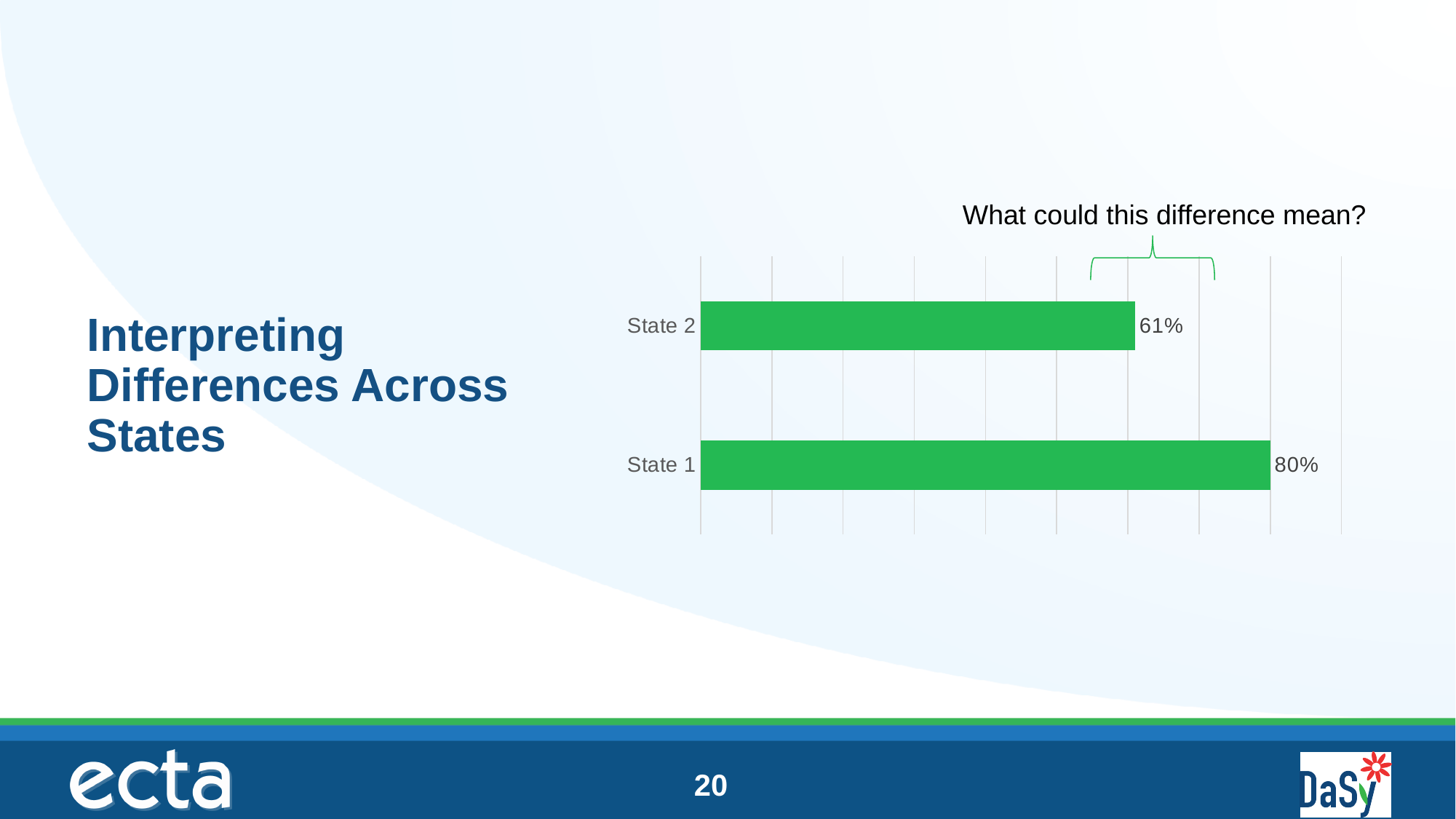
What is the difference between the values for State 1 and State 2? 19% Is the value for State 2 larger or smaller than the value for State 1? smaller What is the value for State 1? 80% Which state has the higher value? State 1 What kind of chart is shown on the slide? bar chart What question is written above the chart? What could this difference mean? How many states are shown in the chart? 2 What is the value for State 2? 61% What colour are the bars in the chart? green Which state has the lower value? State 2